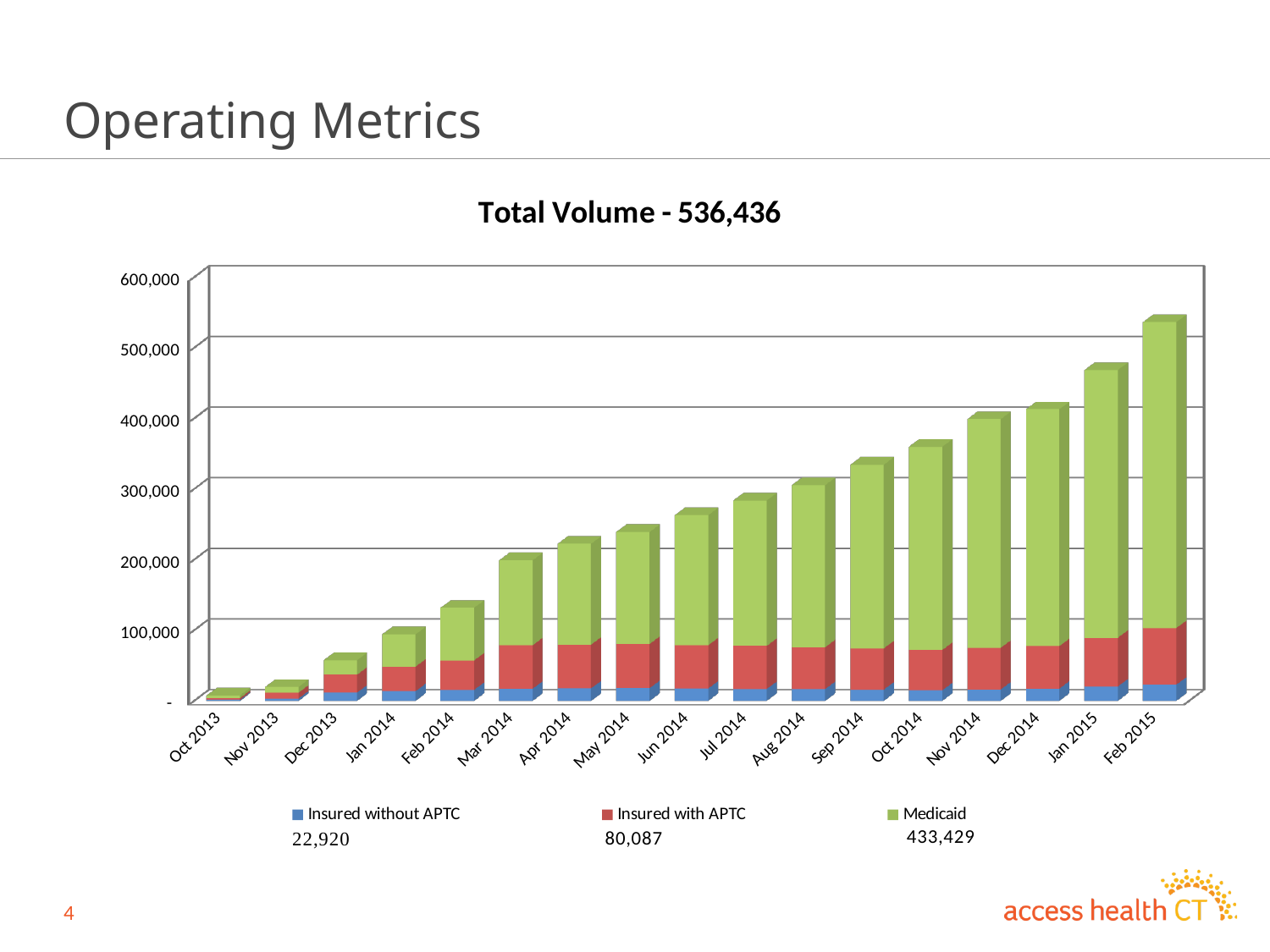
What total volume is stated in the chart title? 536,436 What value is printed beneath the Medicaid legend entry? 433,429 How many months are shown along the x axis? 17 How many series does the legend list? 3 Is the total for Jan 2015 greater or less than 500,000? less Which month has the shortest stacked bar? Oct 2013 Which month has the tallest stacked bar? Feb 2015 Which series is shown in green? Medicaid Do the stacked bar totals rise or fall from Oct 2013 to Feb 2015? rise Is the total for Sep 2014 greater or less than 300,000? greater Is the total for Feb 2015 greater or less than 500,000? greater What kind of chart is shown on the slide? stacked bar chart